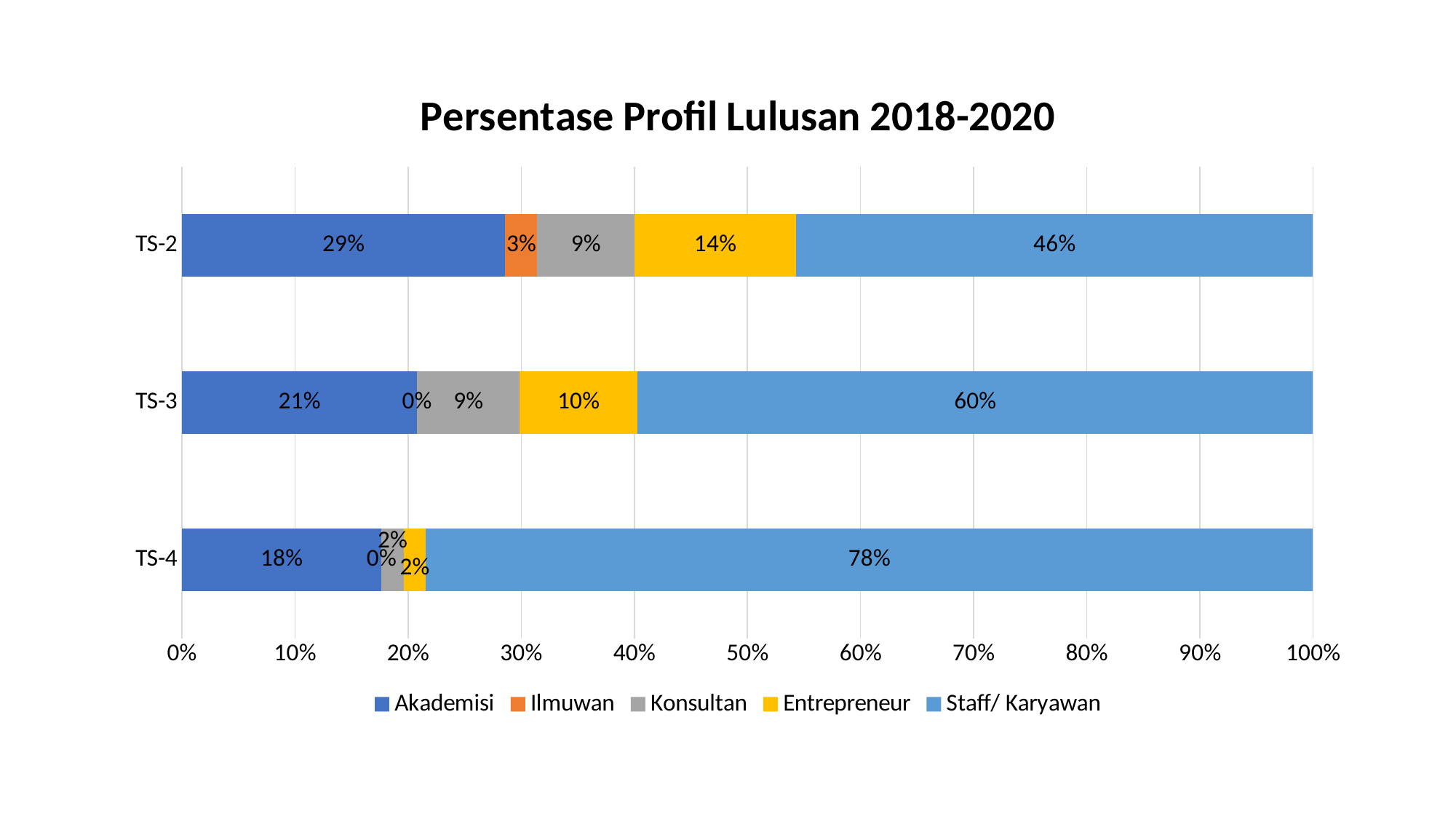
What kind of chart is this? Stacked bar chart What is the Entrepreneur value for TS-3? 10% What is the Akademisi value for TS-2? 29% Which is larger, the Entrepreneur value for TS-2 or for TS-3? TS-2 Which category has the lowest Akademisi value? TS-4 How many categories are shown on the y axis? 3 What is the Staff/ Karyawan value for TS-4? 78% What is the title of the chart? Persentase Profil Lulusan 2018-2020 How many series does the legend list? 5 What is the Ilmuwan value for TS-2? 3% Which category has the highest Staff/ Karyawan value? TS-4 What is the difference between the Staff/ Karyawan values for TS-3 and TS-2? 14%